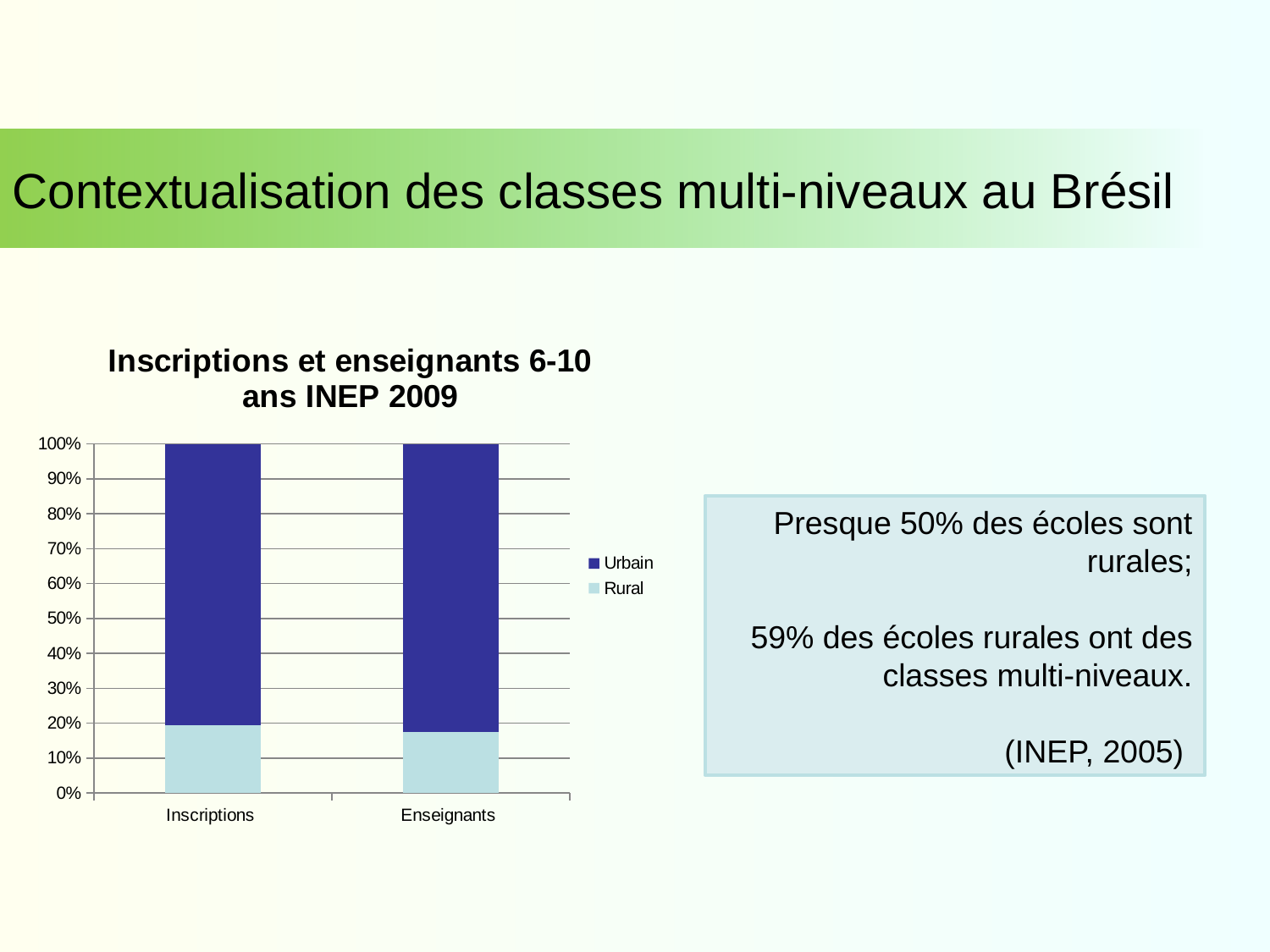
What is the title of the chart? Inscriptions et enseignants 6-10 ans INEP 2009 Is the Rural value for Inscriptions greater or less than 30%? less How many series does the chart legend list? 2 For Enseignants, which series has the smaller share, Urbain or Rural? Rural What is the total height of the stacked bar for Enseignants? 100% Is the Rural value for Enseignants greater or less than 20%? less What kind of chart is shown on the slide? Stacked bar chart What is the total height of the stacked bar for Inscriptions? 100% For Inscriptions, which series has the larger share, Urbain or Rural? Urbain How many categories are shown on the x axis of the chart? 2 Is the Urbain share for Enseignants greater or less than 50%? greater Which series are listed in the chart legend? Urbain and Rural